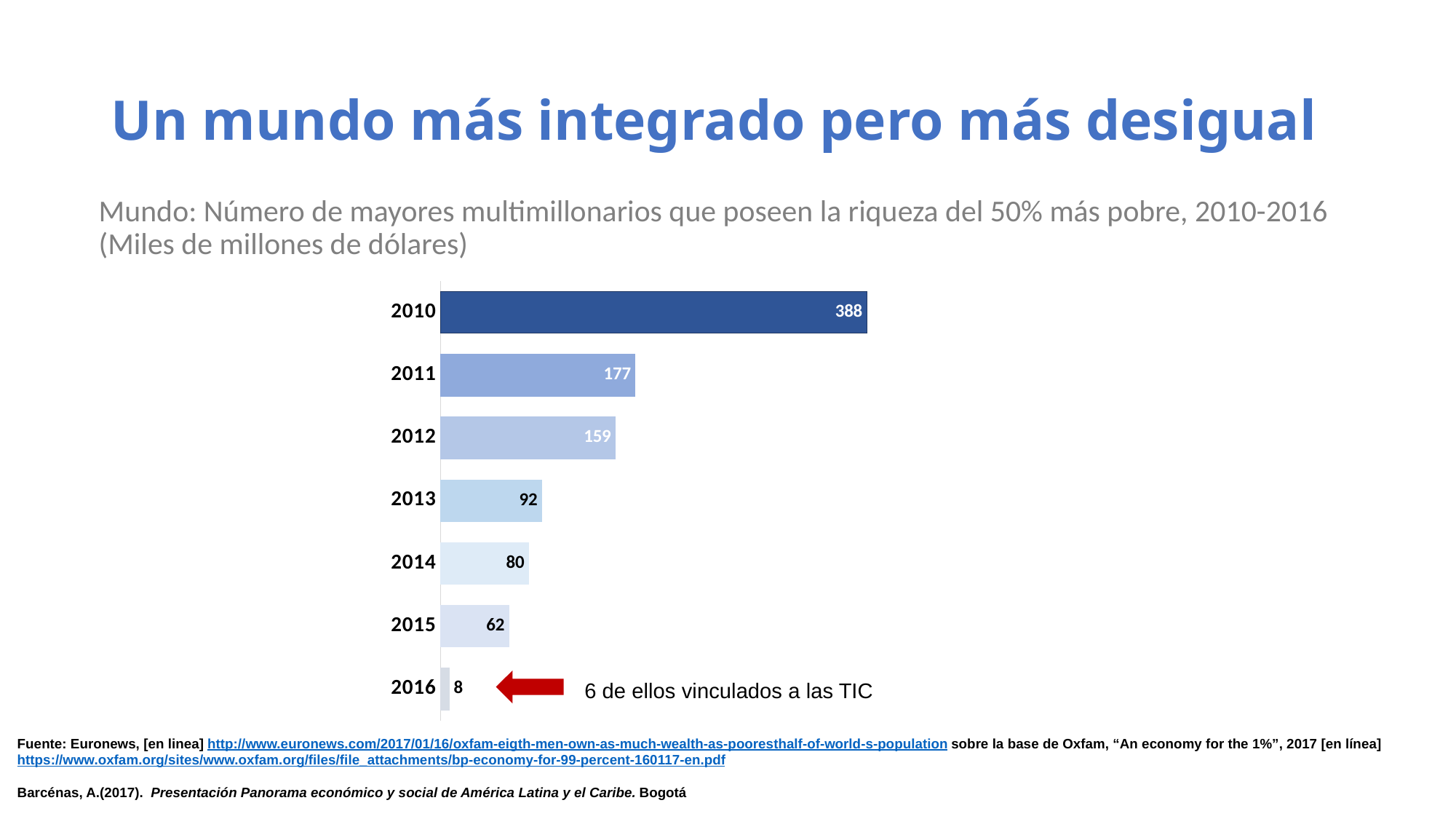
Which year has the highest value? 2010 What is the value for 2010? 388 Do the values rise or fall from 2010 to 2016? Fall Which year has the lowest value? 2016 What is the value for 2016? 8 What kind of chart is shown on the slide? Bar chart What is the difference between the values for 2010 and 2011? 211 What is the difference between the values for 2014 and 2015? 18 Which is larger, the value for 2011 or the value for 2012? 2011 How many years are shown in the chart? 7 What does the annotation next to the 2016 bar say? 6 de ellos vinculados a las TIC What is the value for 2013? 92